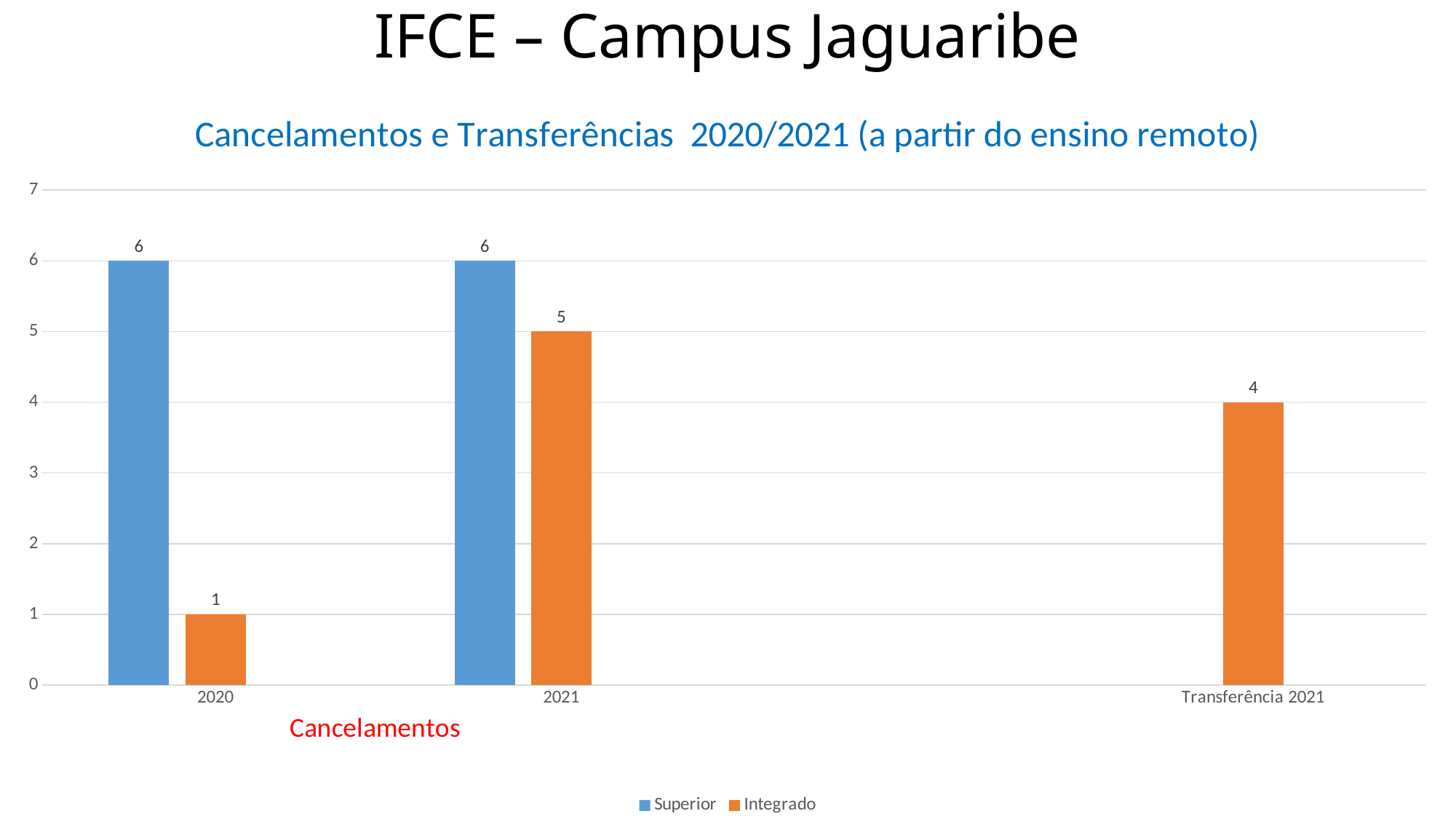
What is the title of the chart? Cancelamentos e Transferências 2020/2021 (a partir do ensino remoto) Which category has the highest Integrado value? 2021 What is the value for Integrado in 2020? 1 What is the difference between the Superior and Integrado values in 2020? 5 Which category has the lowest Integrado value? 2020 How many series does the legend list? 2 What is the value for Integrado in Transferência 2021? 4 What is the value for Superior in 2020? 6 What is the difference between the Integrado values for 2021 and 2020? 4 What kind of chart is shown on the slide? Bar chart What is the value for Integrado in 2021? 5 Which is larger in 2021, the Superior value or the Integrado value? Superior